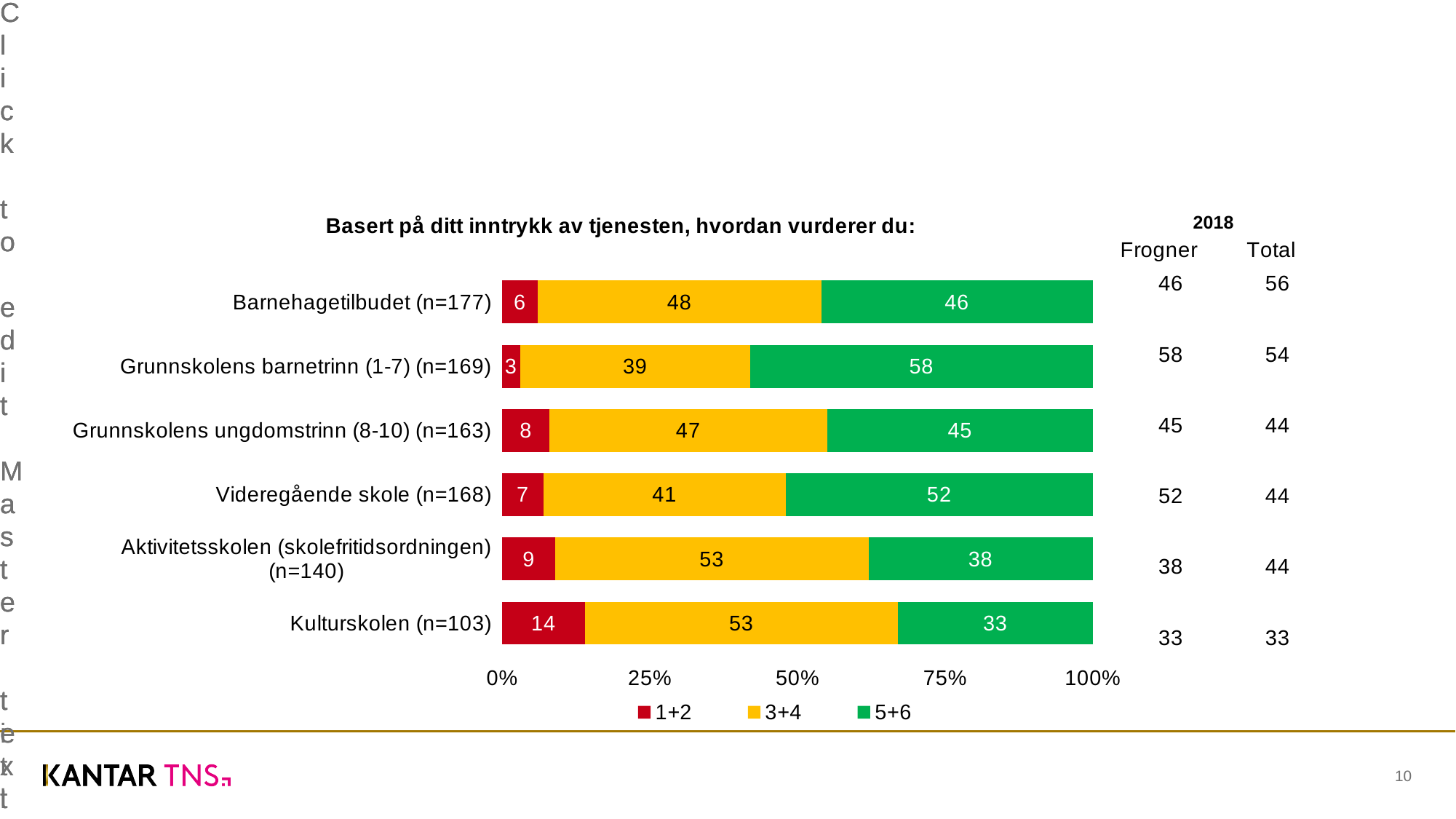
Which is larger: the 3+4 value for Barnehagetilbudet (n=177) or the 3+4 value for Videregående skole (n=168)? Barnehagetilbudet (n=177) What is the value of the 3+4 series for Aktivitetsskolen (skolefritidsordningen) (n=140)? 53 What is the title of the chart? Basert på ditt inntrykk av tjenesten, hvordan vurderer du: What is the total of the stacked bar for Grunnskolens ungdomstrinn (8-10) (n=163)? 100 How many categories are shown on the chart? 6 Which category has the lowest value for the 1+2 series? Grunnskolens barnetrinn (1-7) (n=169) What is the difference between the 5+6 values for Videregående skole (n=168) and Kulturskolen (n=103)? 19 Which category has the highest value for the 5+6 series? Grunnskolens barnetrinn (1-7) (n=169) What is the value of the 1+2 series for Kulturskolen (n=103)? 14 What kind of chart is shown on the slide? Stacked bar chart How many series does the legend list? 3 What is the value of the 5+6 series for Grunnskolens barnetrinn (1-7) (n=169)? 58